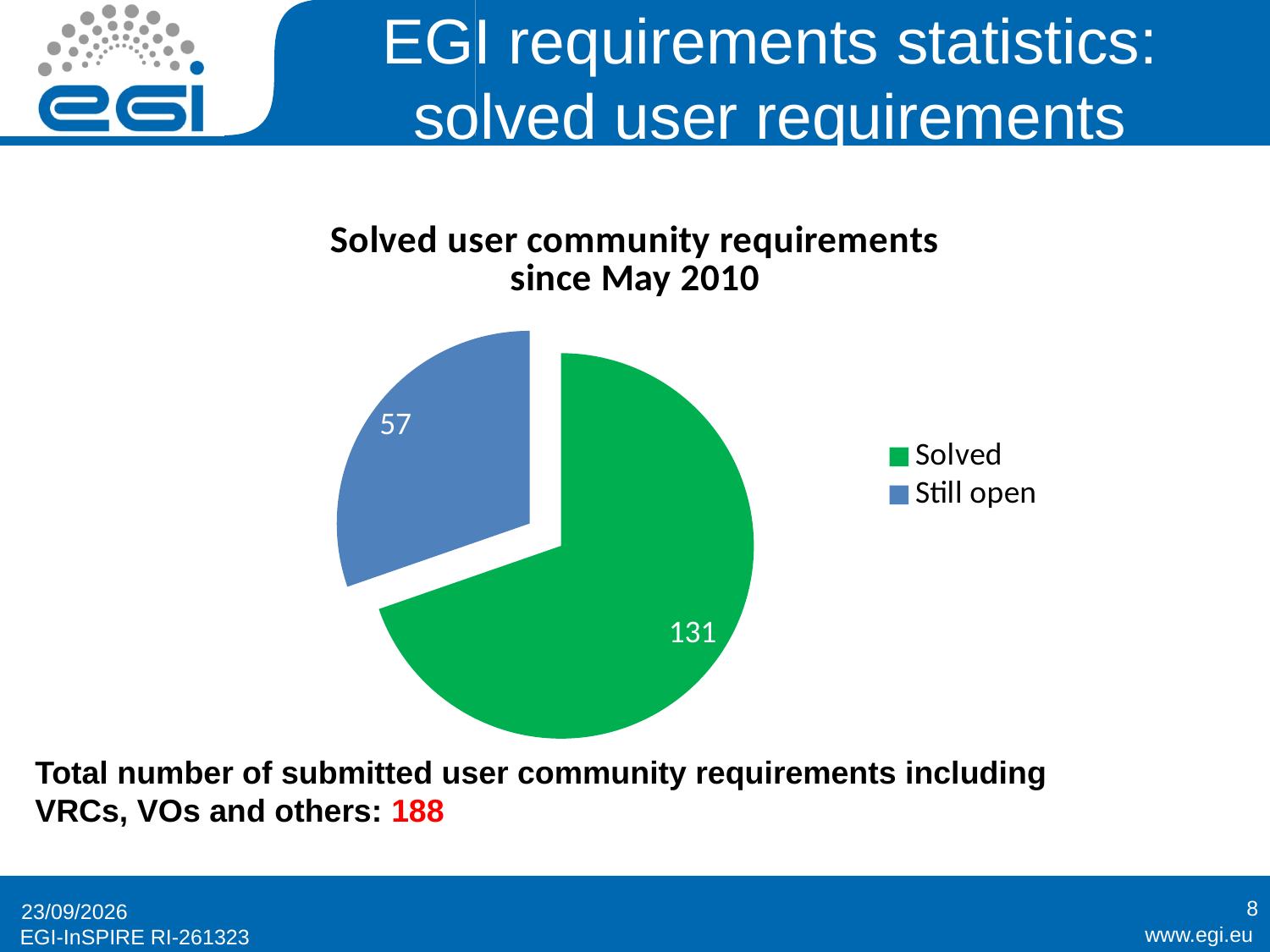
What is the title of the chart? Solved user community requirements since May 2010 Which slice of the pie chart is the largest? Solved What type of chart is shown on the slide? pie chart Which slice of the pie chart is the smallest? Still open How many requirements are shown as Solved in the pie chart? 131 How many requirements are shown as Still open in the pie chart? 57 How many entries does the legend list? 2 What is the total of the two slices in the pie chart? 188 Which is larger, the Solved slice or the Still open slice? Solved What is the difference between the number of Solved and Still open requirements? 74 How many slices does the pie chart have? 2